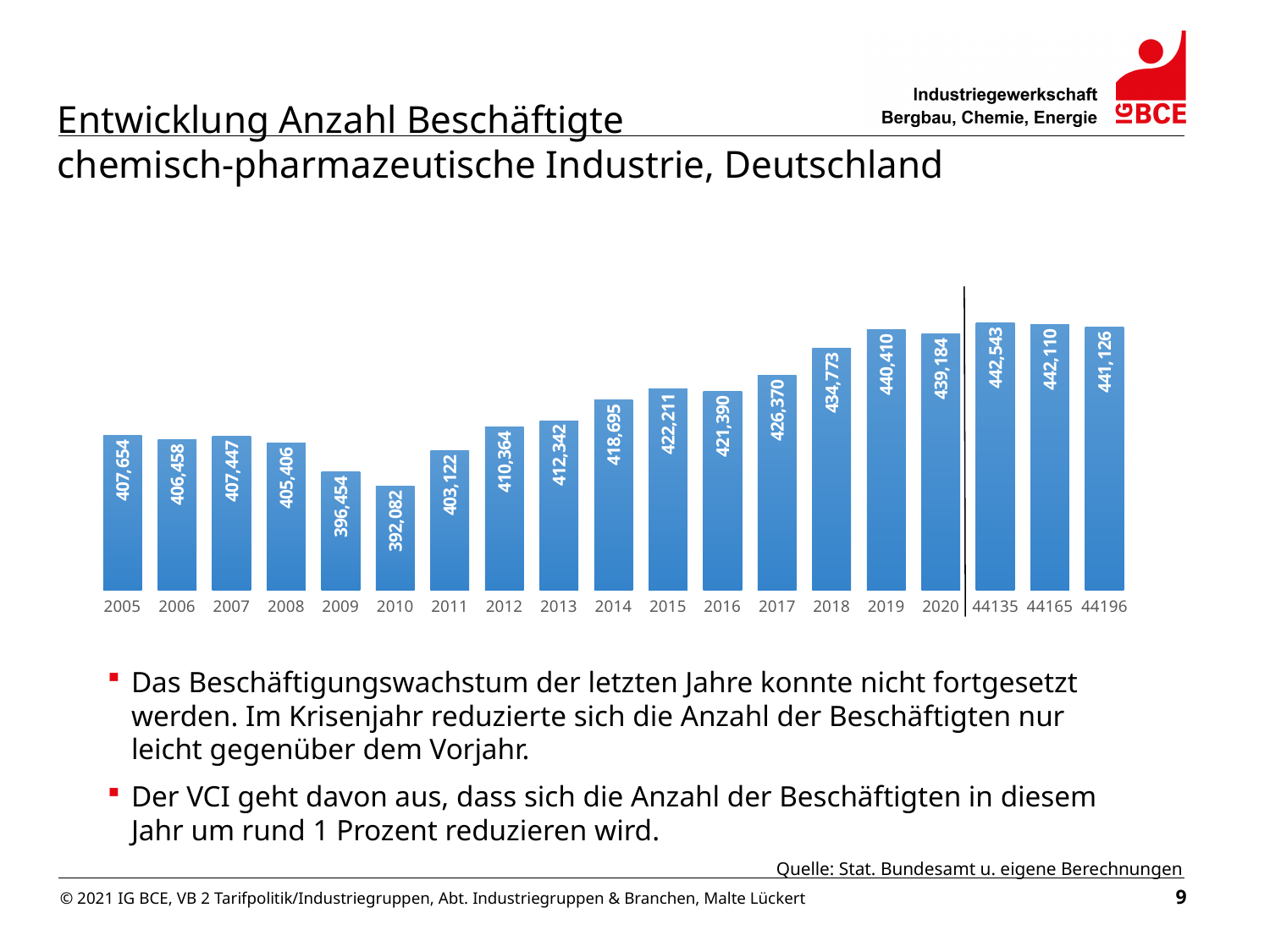
Which category has the highest value? 44135 What is the difference between the values for 2019 and 2020? 1,226 What is the value for 2010? 392,082 Which is larger, the value for 2018 or the value for 2017? 2018 What is the difference between the values for 2005 and 2010? 15,572 What is the value for 2020? 439,184 How many bars are shown in the chart? 19 Do the values rise or fall from 2010 to 2019? Rise Which year has the lowest value? 2010 What is the value for 2005? 407,654 What kind of chart is shown on the slide? Bar chart What is the value for the category labelled 44135? 442,543